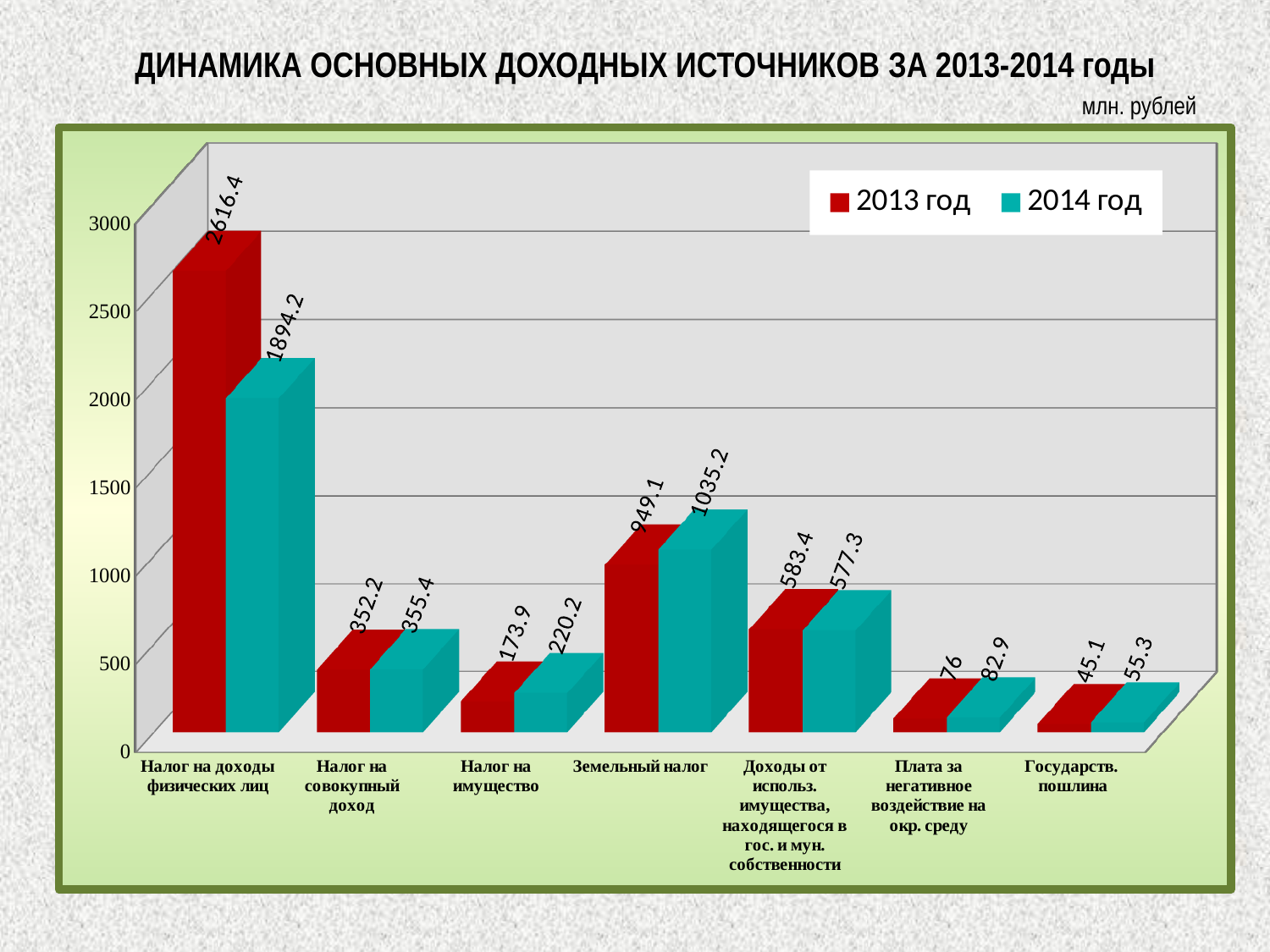
What is the value for Налог на доходы физических лиц in 2013 год? 2616.4 What kind of chart is shown on the slide? Bar chart How many categories are shown on the x axis? 7 Which category has the highest value in 2013 год? Налог на доходы физических лиц How many series does the legend list? 2 What is the value for Плата за негативное воздействие на окр. среду in 2013 год? 76 Which is larger for Налог на имущество: the 2013 год value or the 2014 год value? 2014 год What is the value for Земельный налог in 2014 год? 1035.2 What is the value for Государств. пошлина in 2014 год? 55.3 What unit is indicated above the chart? млн. рублей Which category has the lowest value in 2014 год? Государств. пошлина What is the difference between the 2013 год and 2014 год values for Налог на доходы физических лиц? 722.2